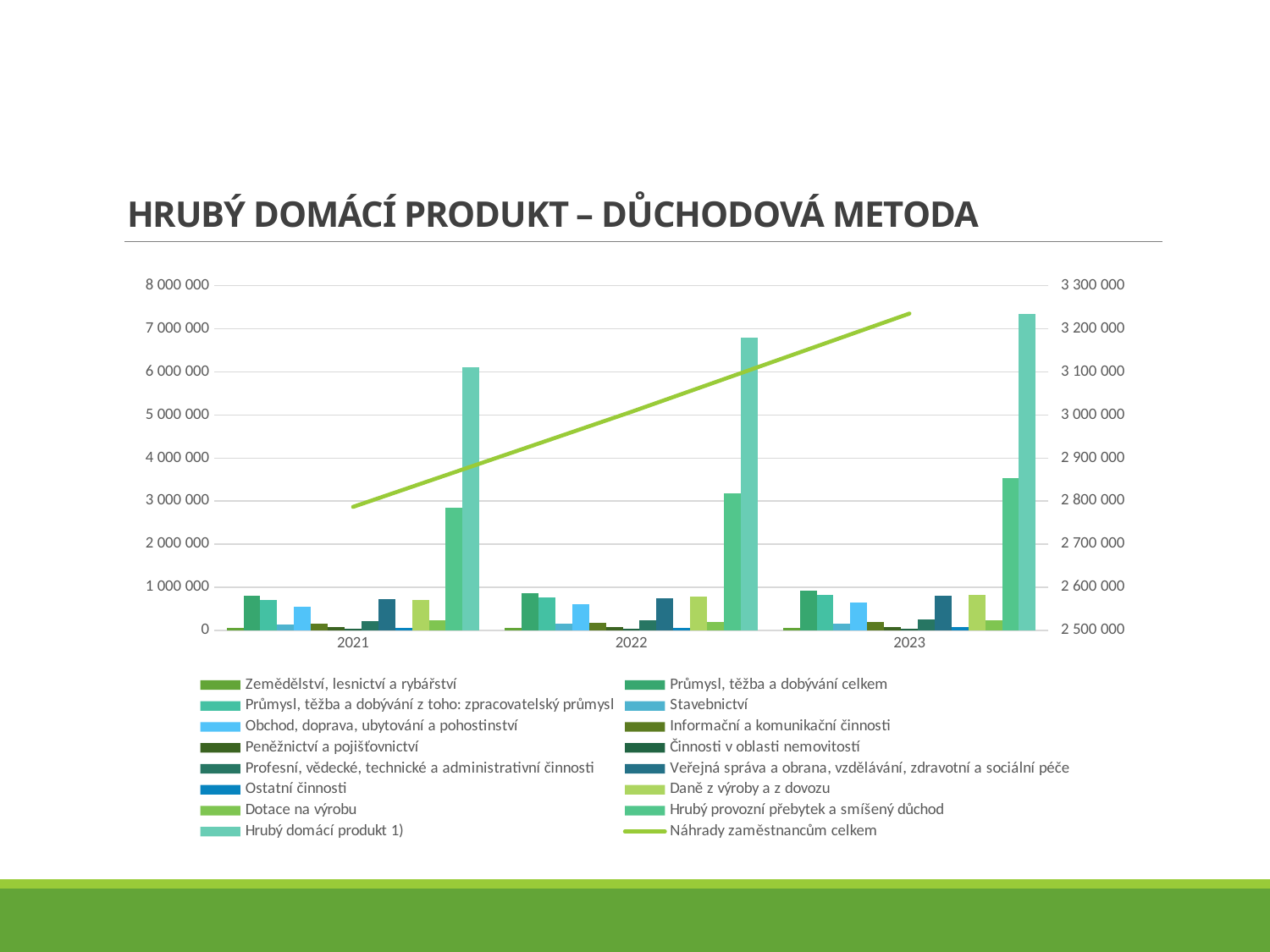
How many years (categories) are shown on the x axis? 3 What kind of chart is shown on the slide? A bar chart combined with a line Is the value for Hrubý provozní přebytek a smíšený důchod in 2023 greater or less than 3 000 000? greater Does the Náhrady zaměstnancům celkem line rise or fall from 2021 to 2023? rise Is the value for Hrubý domácí produkt 1) in 2022 greater or less than 6 000 000? greater Is the value for Hrubý domácí produkt 1) in 2023 greater or less than 7 000 000? greater Which is larger, Hrubý domácí produkt 1) in 2021 or in 2023? 2023 Which series has the tallest bar in 2023? Hrubý domácí produkt 1) Which series is plotted as a line rather than bars? Náhrady zaměstnancům celkem How many series does the legend list? 16 What is the title of the chart? HRUBÝ DOMÁCÍ PRODUKT – DŮCHODOVÁ METODA